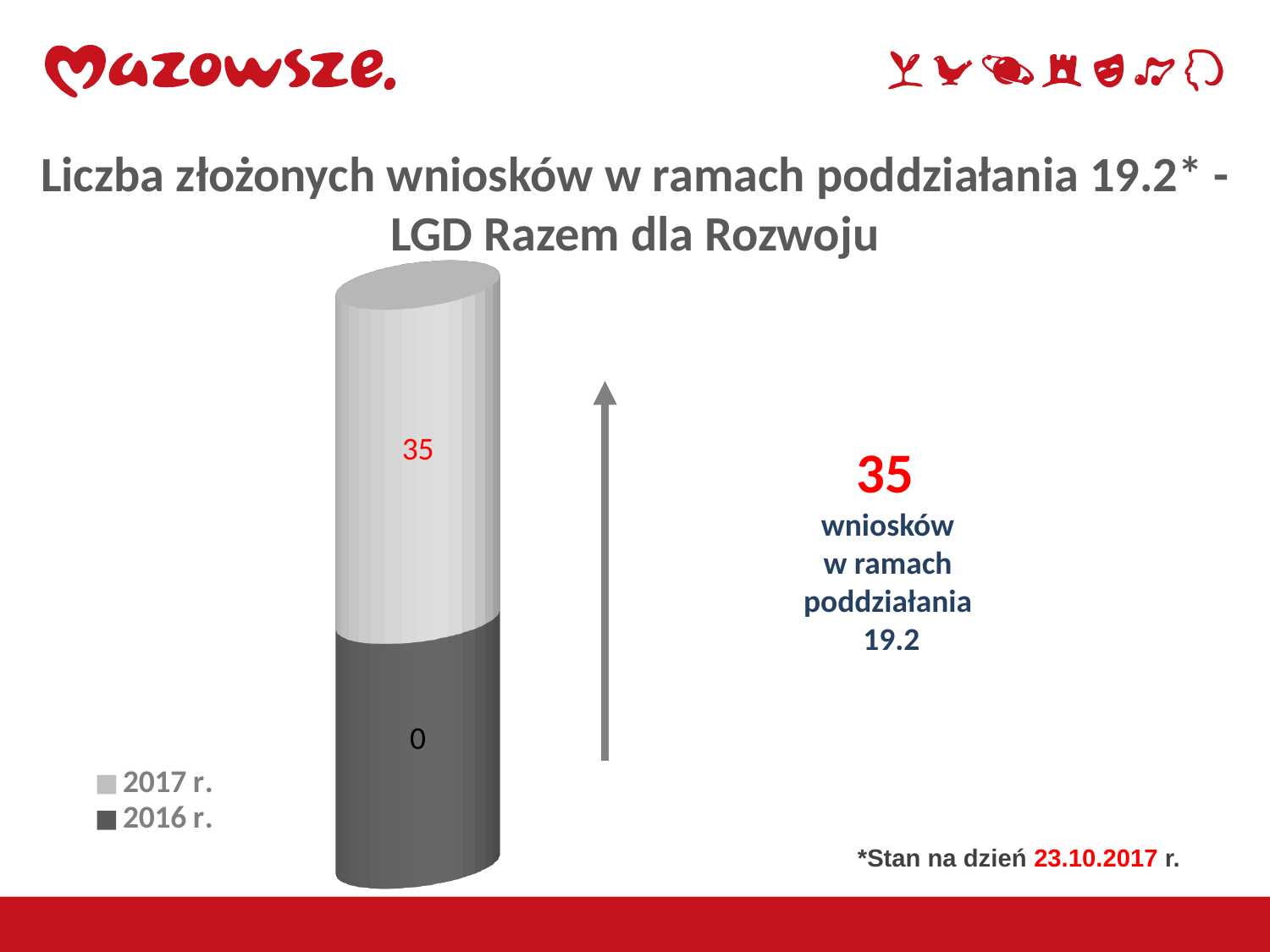
Which series has the highest value on the chart? 2017 r. Which series has the higher value, 2017 r. or 2016 r.? 2017 r. What is the difference between the 2017 r. value and the 2016 r. value? 35 What kind of chart is shown on the slide? Stacked bar chart Which series is shown in the darker grey colour according to the legend? 2016 r. What value is shown for the 2017 r. series on the chart? 35 What is the total of the stacked bar (2016 r. plus 2017 r.)? 35 How many series does the legend list? 2 Did the number of submitted applications rise or fall from 2016 r. to 2017 r.? Rise Which series has the lowest value on the chart? 2016 r. What value is shown for the 2016 r. series on the chart? 0 What is the title of the chart? Liczba złożonych wniosków w ramach poddziałania 19.2* - LGD Razem dla Rozwoju